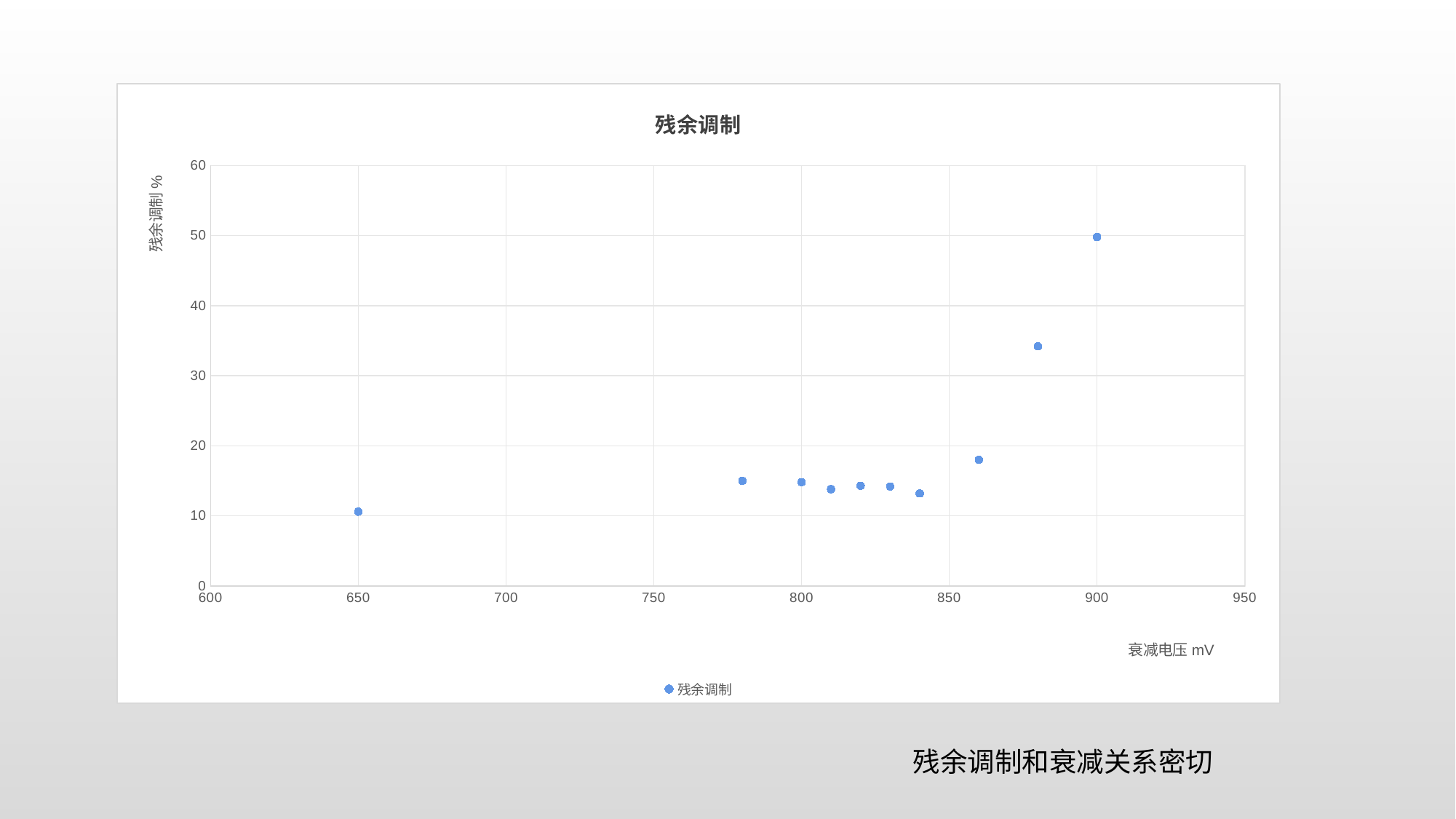
Between 衰减电压 840 and 900, do the values rise or fall? rise How many series does the legend list? 1 Is the value for 衰减电压 880 greater or less than 30? greater What is the title of the chart? 残余调制 What is the label of the x axis? 衰减电压 mV What kind of chart is shown on the slide? scatter chart At which x value (衰减电压) is the 残余调制 highest? 900 At which x value (衰减电压) is the 残余调制 lowest? 650 Which has the larger 残余调制 value: 衰减电压 880 or 860? 880 How many data points are plotted in the chart? 10 Is the value for 衰减电压 900 greater or less than 40? greater Is the value for 衰减电压 860 greater or less than 20? less